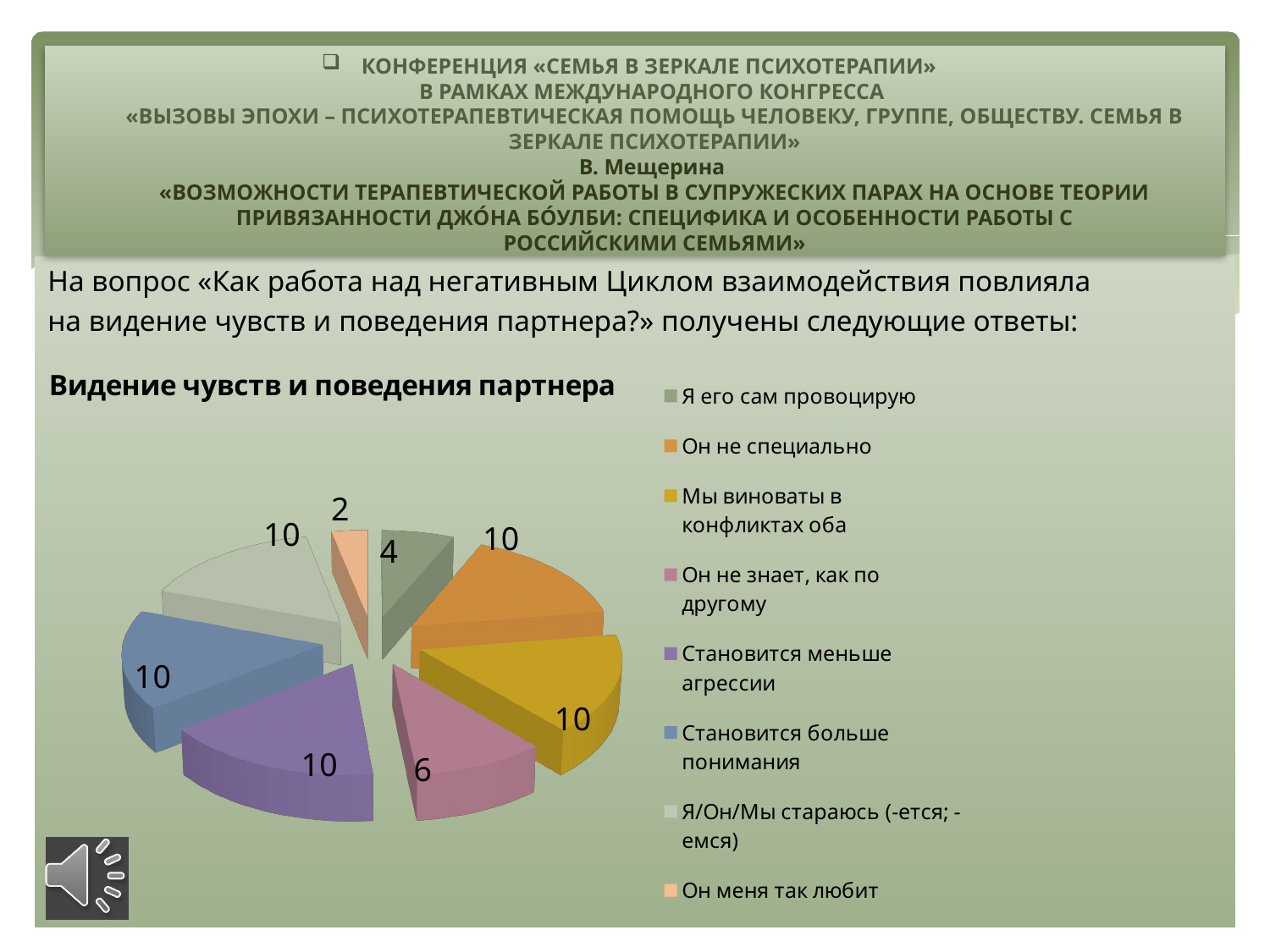
What is the value for "Он не знает, как по другому"? 6 What is the difference between the values for "Он не специально" and "Он не знает, как по другому"? 4 What is the value for "Он меня так любит"? 2 What kind of chart is shown on the slide? pie chart Which category has the smallest slice? Он меня так любит Which is larger: the value for "Я его сам провоцирую" or the value for "Он не знает, как по другому"? Он не знает, как по другому What is the value for "Становится больше понимания"? 10 What is the value for "Я его сам провоцирую"? 4 What is the title of the chart? Видение чувств и поведения партнера What is the total of all the values in the pie chart? 62 How many categories have a value of 10? 5 How many slices does the pie chart have? 8